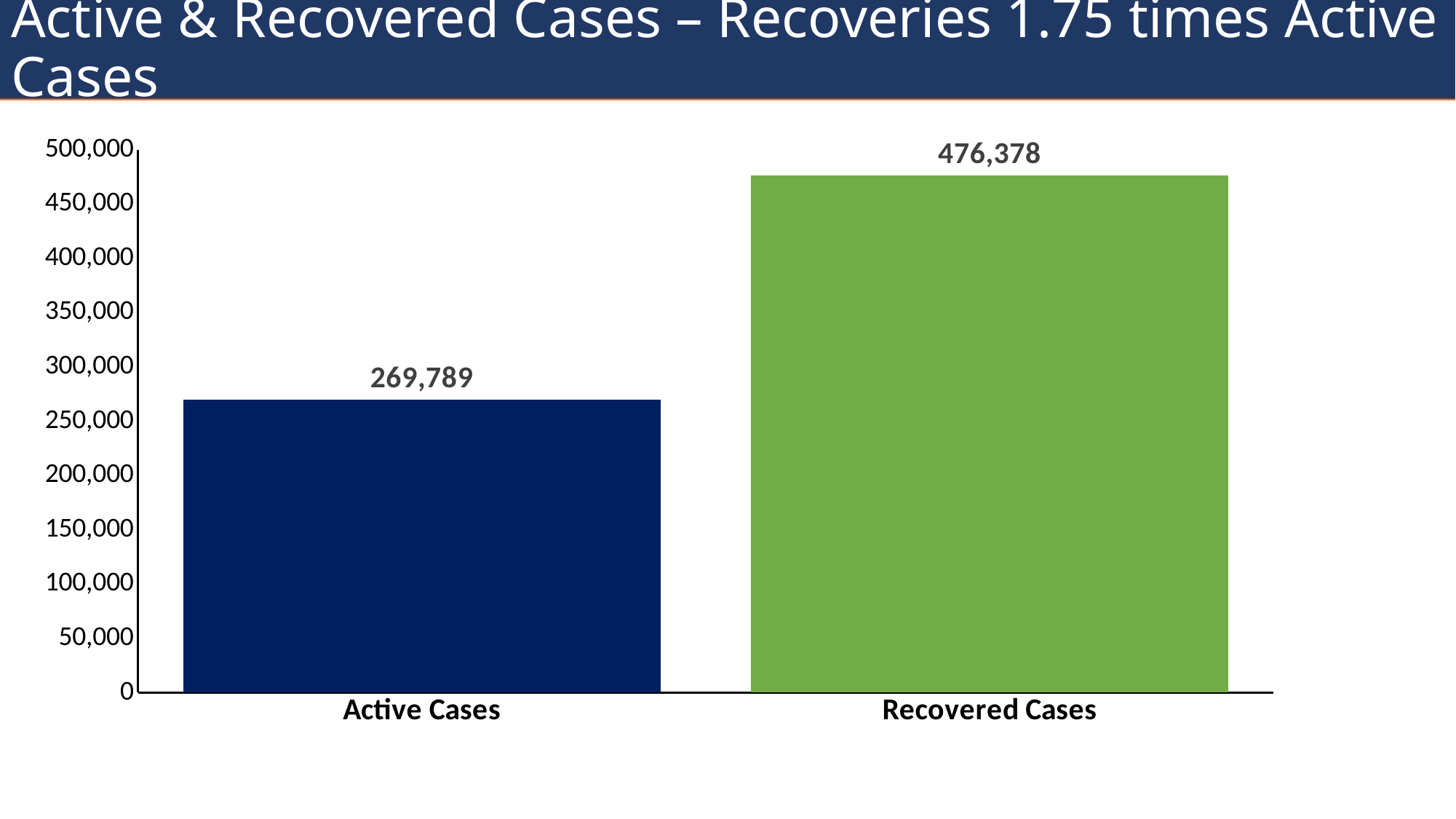
Is the value for Recovered Cases greater or less than 450,000? greater What is the value for Active Cases? 269,789 Which category has the highest value? Recovered Cases What kind of chart is shown on the slide? Bar chart Is the value for Active Cases greater or less than 300,000? less What is the value for Recovered Cases? 476,378 Which category has the lowest value? Active Cases What is the total of Active Cases and Recovered Cases? 746,167 Which is larger, Active Cases or Recovered Cases? Recovered Cases What colour is the bar for Recovered Cases? Green How many categories are shown on the chart? 2 What is the difference between Recovered Cases and Active Cases? 206,589